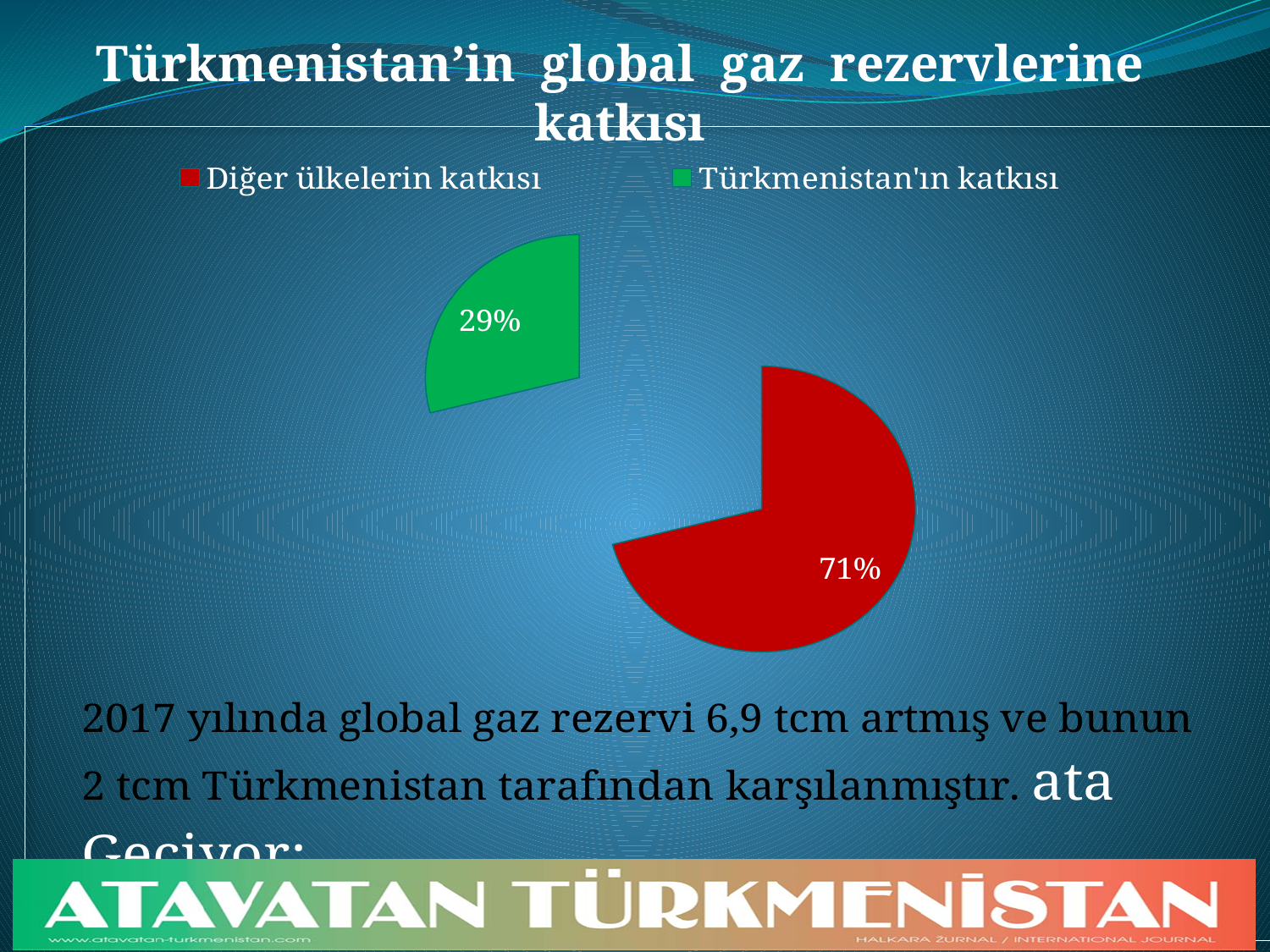
How many entries does the legend list? 2 What share of the pie does "Türkmenistan'ın katkısı" represent? 29% How many slices does the pie chart have? 2 What is the difference in percentage points between the "Diğer ülkelerin katkısı" slice and the "Türkmenistan'ın katkısı" slice? 42 What is the title of the chart? Türkmenistan'in global gaz rezervlerine katkısı What kind of chart is shown on the slide? pie chart Which slice of the pie is the smallest? Türkmenistan'ın katkısı Which is larger: the share for "Diğer ülkelerin katkısı" or the share for "Türkmenistan'ın katkısı"? Diğer ülkelerin katkısı What colour is the slice for "Türkmenistan'ın katkısı"? green What share of the pie does "Diğer ülkelerin katkısı" represent? 71% Which slice of the pie is the largest? Diğer ülkelerin katkısı